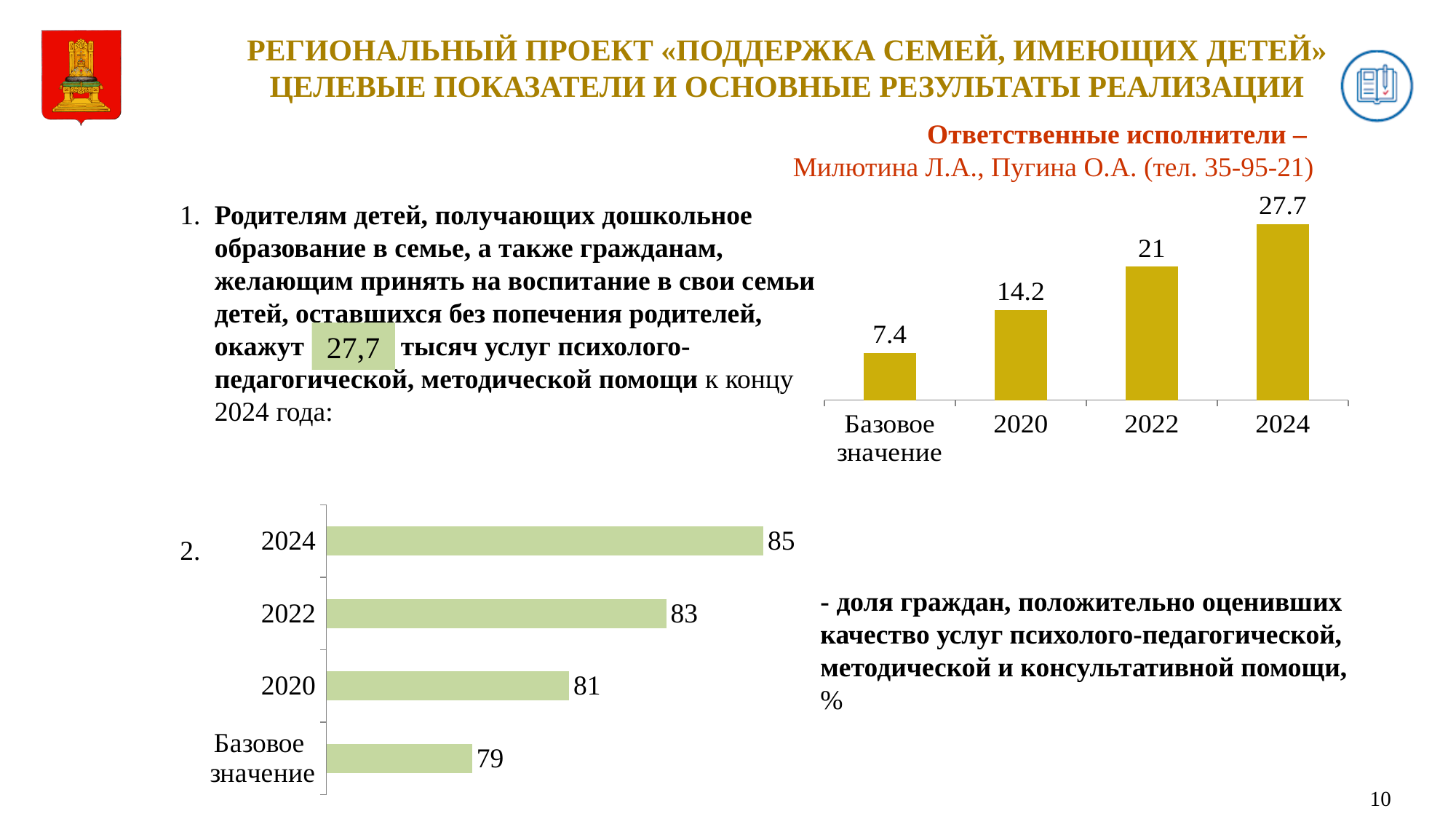
In the top-right chart, what is the value for 2022? 21 In the top-right chart, which category has the highest value? 2024 What kind of chart is the bottom-left chart? bar chart In the top-right chart, what is the value for Базовое значение? 7.4 In the bottom-left chart, which is larger: the value for 2022 or the value for 2020? 2022 In the bottom-left chart, which category has the lowest value? Базовое значение In the top-right chart, do the values rise or fall from Базовое значение to 2024? rise In the bottom-left chart, what is the value for Базовое значение? 79 In the top-right chart, how many bars are plotted? 4 In the bottom-left chart, what is the difference between the values for 2024 and 2022? 2 In the top-right chart, what is the difference between the values for 2024 and 2020? 13.5 In the bottom-left chart, what is the value for 2020? 81